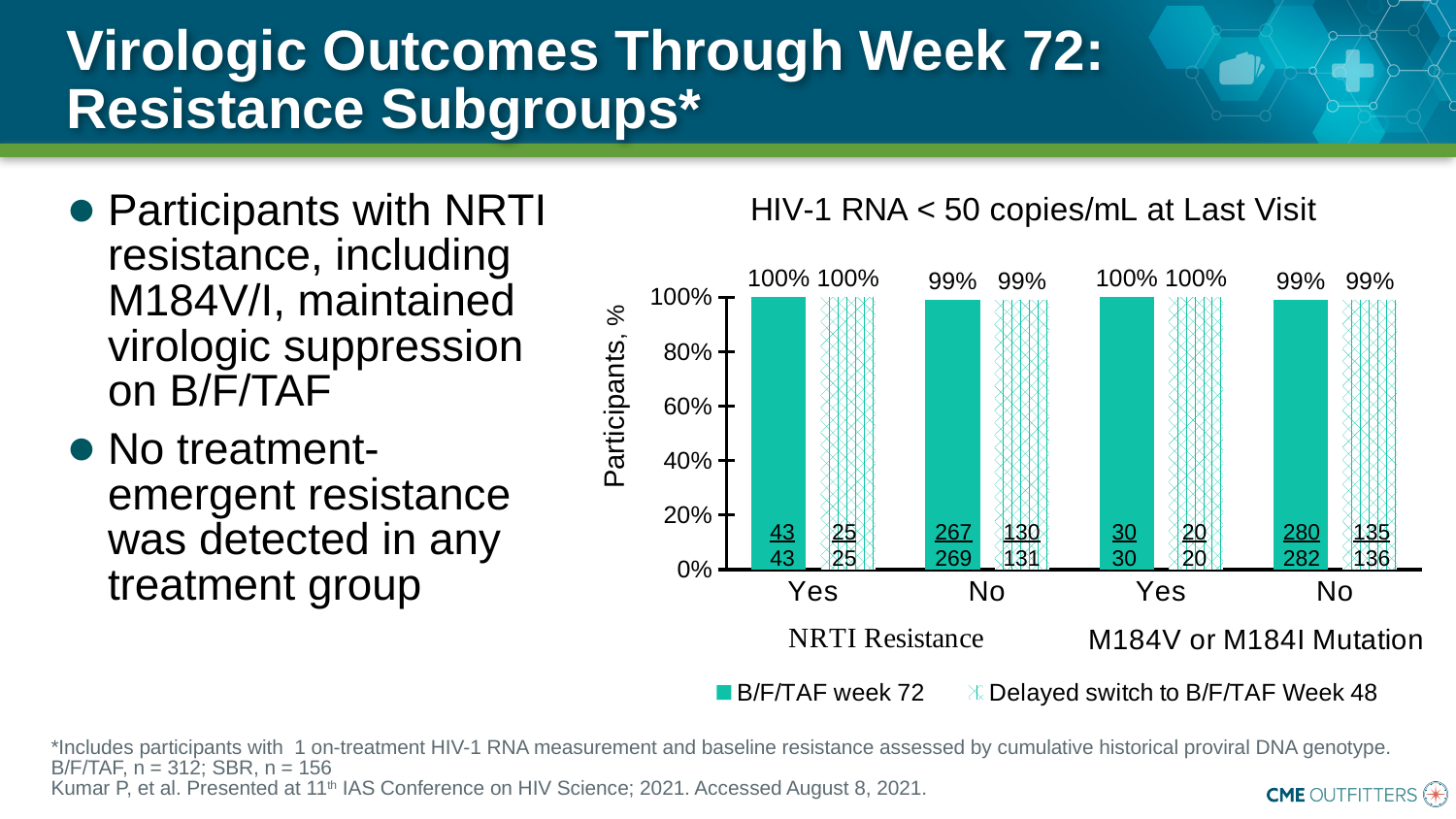
What is the value for B/F/TAF week 72 in the M184V or M184I Mutation 'No' group? 99% How many series does the chart legend list? 2 What fraction is printed on the B/F/TAF week 72 bar for the NRTI Resistance 'No' group? 267/269 What fraction is printed on the Delayed switch to B/F/TAF Week 48 bar for the M184V or M184I Mutation 'No' group? 135/136 What is the title of the chart? HIV-1 RNA < 50 copies/mL at Last Visit What is the value for B/F/TAF week 72 in the NRTI Resistance 'Yes' group? 100% What is the value for Delayed switch to B/F/TAF Week 48 in the NRTI Resistance 'No' group? 99% What is the value for Delayed switch to B/F/TAF Week 48 in the M184V or M184I Mutation 'Yes' group? 100% What is the difference between the B/F/TAF week 72 values for the NRTI Resistance 'Yes' and 'No' groups? 1% Is the value for B/F/TAF week 72 in the M184V or M184I Mutation 'Yes' group greater or less than 80%? greater What kind of chart is shown on the slide? bar chart How many category groups are shown along the x axis? 4